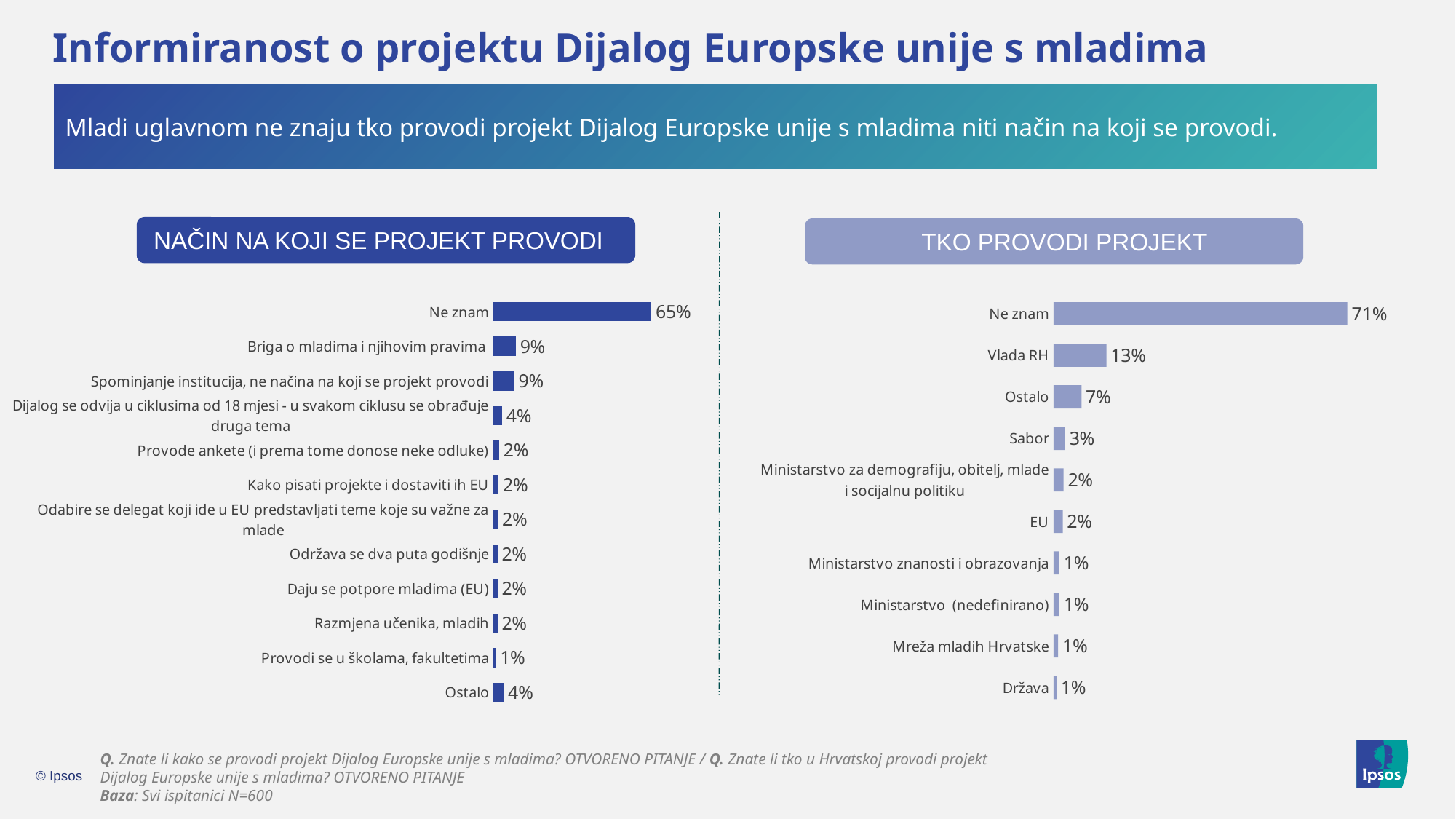
In the chart titled "TKO PROVODI PROJEKT", which category has the highest value? Ne znam How many categories are shown in the chart titled "TKO PROVODI PROJEKT"? 10 In the chart titled "NAČIN NA KOJI SE PROJEKT PROVODI", what is the value for "Ne znam"? 65% In the chart titled "NAČIN NA KOJI SE PROJEKT PROVODI", which is larger, the value for "Briga o mladima i njihovim pravima" or the value for "Ostalo"? Briga o mladima i njihovim pravima How many categories are shown in the chart titled "NAČIN NA KOJI SE PROJEKT PROVODI"? 12 In the chart titled "TKO PROVODI PROJEKT", which is larger, the value for "Ostalo" or the value for "Sabor"? Ostalo In the chart titled "TKO PROVODI PROJEKT", what is the value for "Sabor"? 3% In the chart titled "TKO PROVODI PROJEKT", what is the value for "Vlada RH"? 13% In the chart titled "TKO PROVODI PROJEKT", what is the difference between the values for "Ne znam" and "Vlada RH"? 58% What kind of chart is the chart titled "TKO PROVODI PROJEKT"? Bar chart In the chart titled "NAČIN NA KOJI SE PROJEKT PROVODI", what is the difference between the values for "Ne znam" and "Briga o mladima i njihovim pravima"? 56% In the chart titled "NAČIN NA KOJI SE PROJEKT PROVODI", which category has the lowest value? Provodi se u školama, fakultetima